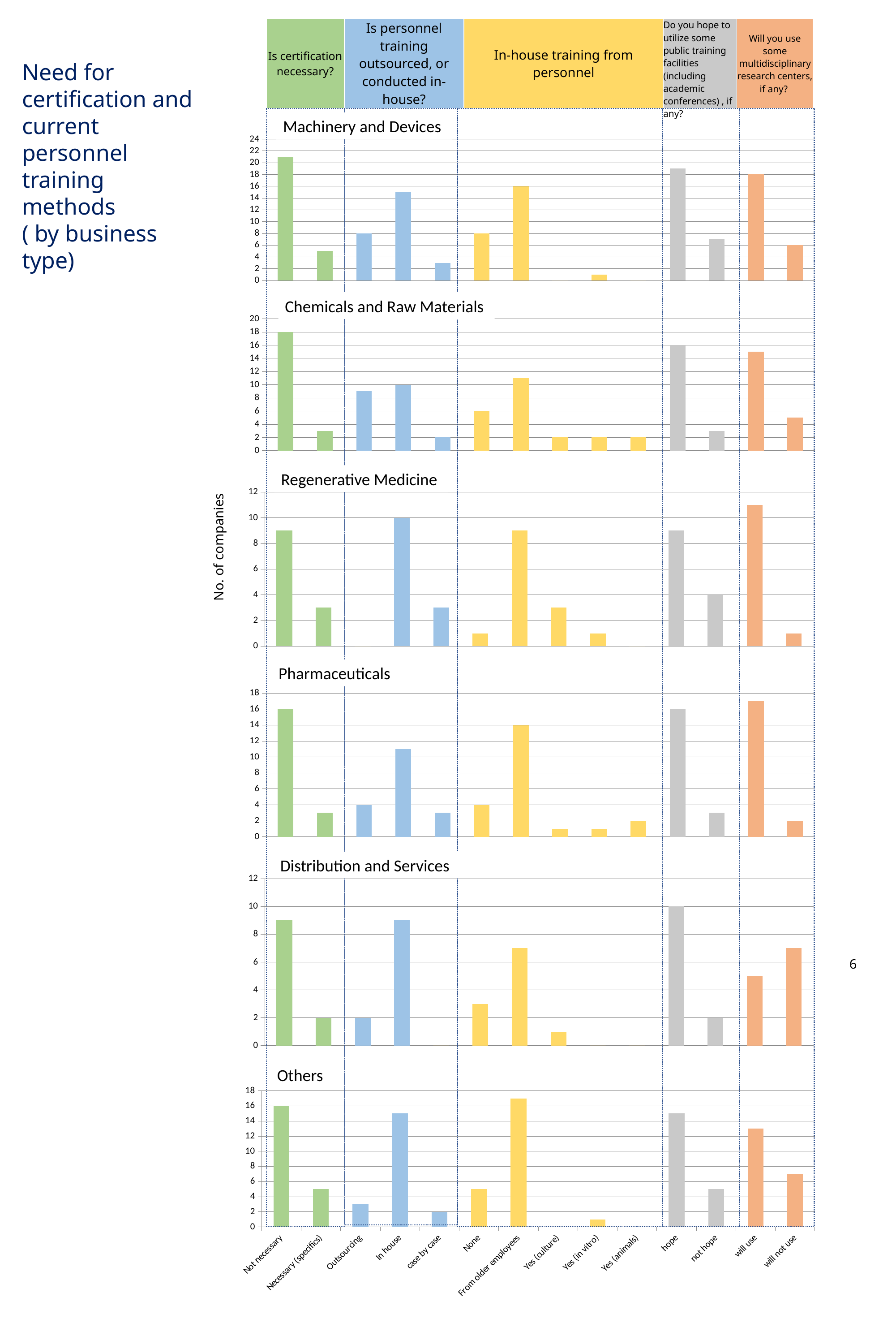
In the Regenerative Medicine chart, what is the value for 'In house'? 10 In the Chemicals and Raw Materials chart, what is the value for 'Not necessary'? 18 In the Machinery and Devices chart, what is the difference between 'From older employees' and 'None'? 8 What kind of chart is used for the Machinery and Devices panel? bar chart In the Pharmaceuticals chart, what is the value for 'From older employees'? 14 In the Machinery and Devices chart, which category has the highest value? Not necessary In the Machinery and Devices chart, what is the value for 'From older employees'? 16 How many business-type panels (charts) are shown on the slide? 6 In the Chemicals and Raw Materials chart, is the value for 'will use' greater or less than 10? greater In the Others chart, is the value for 'In house' greater or less than 10? greater In the Distribution and Services chart, which is larger, 'hope' or 'not hope'? hope In the Machinery and Devices chart, what is the value for 'Outsourcing'? 8